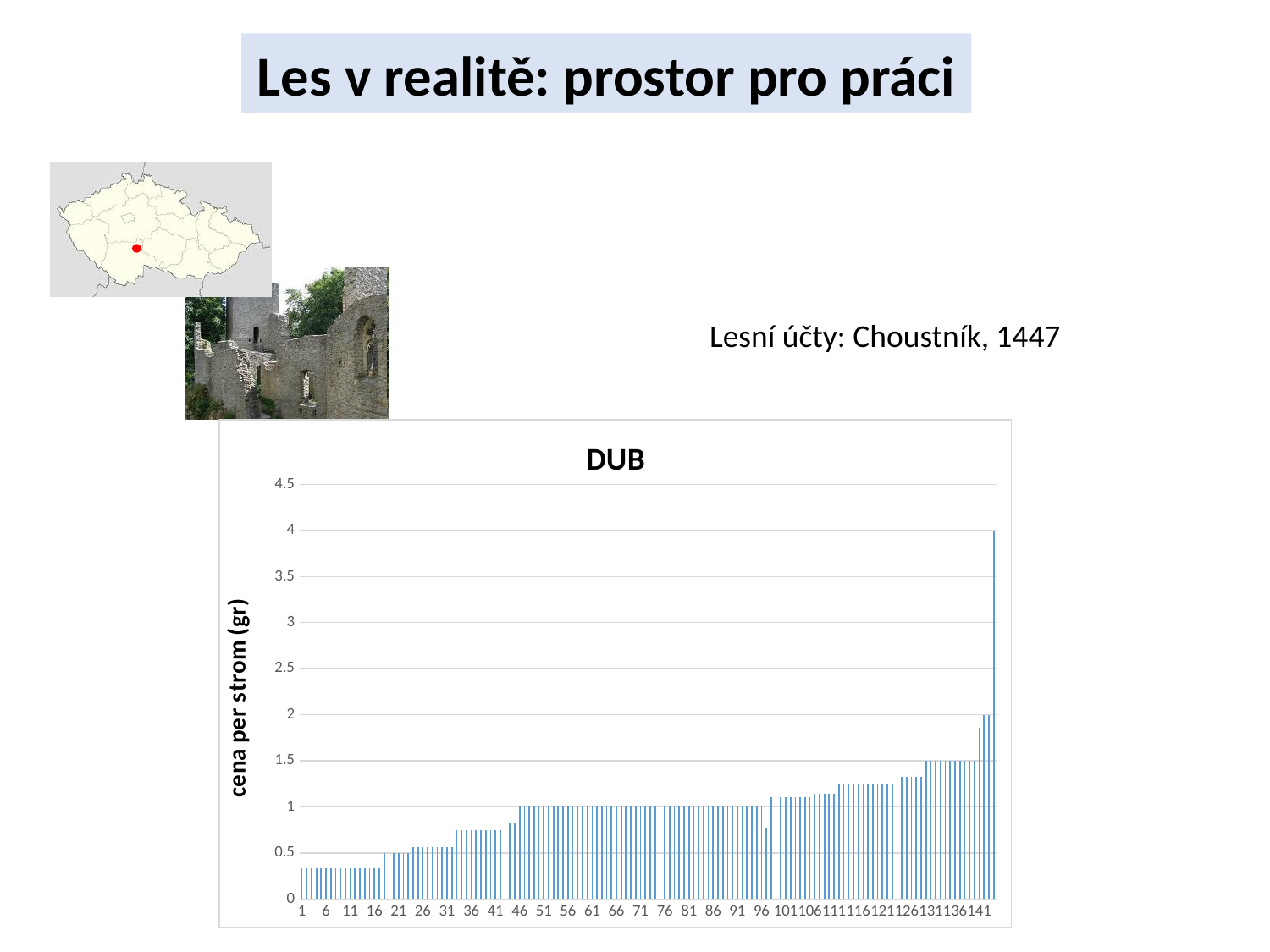
What kind of chart is shown on the slide? bar chart Is the value for category 1 greater or less than 0.5? less Is the value for category 26 greater or less than 0.5? greater What is the highest value shown on the vertical axis of the chart? 4.5 Which is larger, the value for category 136 or the value for category 76? category 136 Is the value for category 121 greater or less than 1.5? less Which is larger, the value for category 11 or the value for category 61? category 61 Do the bar values rise or fall from left to right along the x axis? rise What is the title of the chart? DUB What is the label of the vertical axis of the chart? cena per strom (gr)